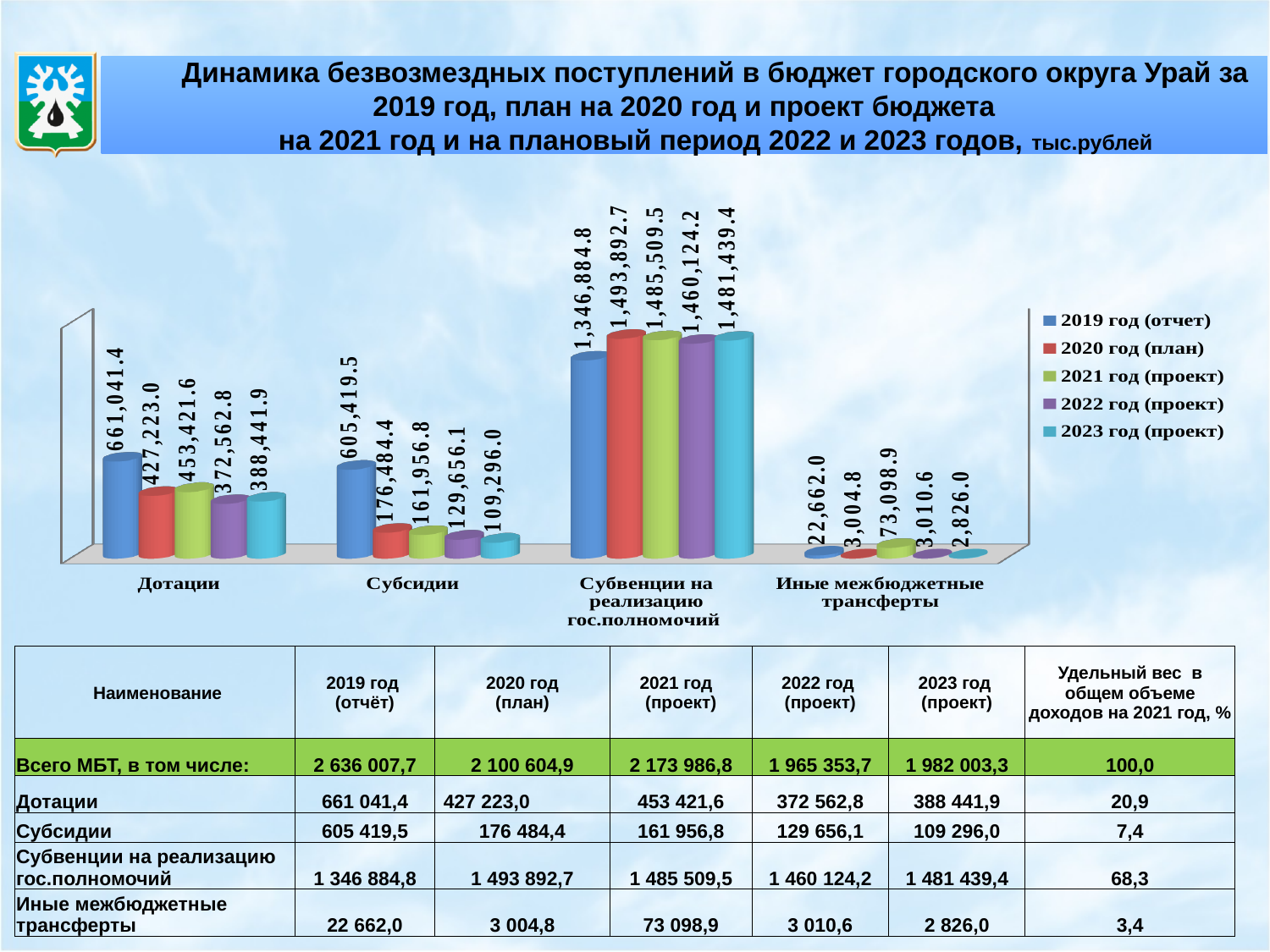
What is the value for Дотации in the 2019 год (отчет) series? 661,041.4 How many series does the chart legend list? 5 What is the value for Субвенции на реализацию гос.полномочий in the 2020 год (план) series? 1,493,892.7 What is the value for Субсидии in the 2023 год (проект) series? 109,296.0 What type of chart is shown on the slide? bar chart How many categories are shown on the x axis of the chart? 4 Which category has the lowest value in the 2022 год (проект) series? Иные межбюджетные трансферты What is the value for Иные межбюджетные трансферты in the 2021 год (проект) series? 73,098.9 What is the difference between the 2019 год (отчет) and 2020 год (план) values for Субсидии? 428,935.1 Which category has the highest value in the 2019 год (отчет) series? Субвенции на реализацию гос.полномочий Do the values for Субсидии rise or fall from the 2019 год (отчет) series to the 2023 год (проект) series? fall Which is larger for Дотации: the 2021 год (проект) value or the 2023 год (проект) value? 2021 год (проект)